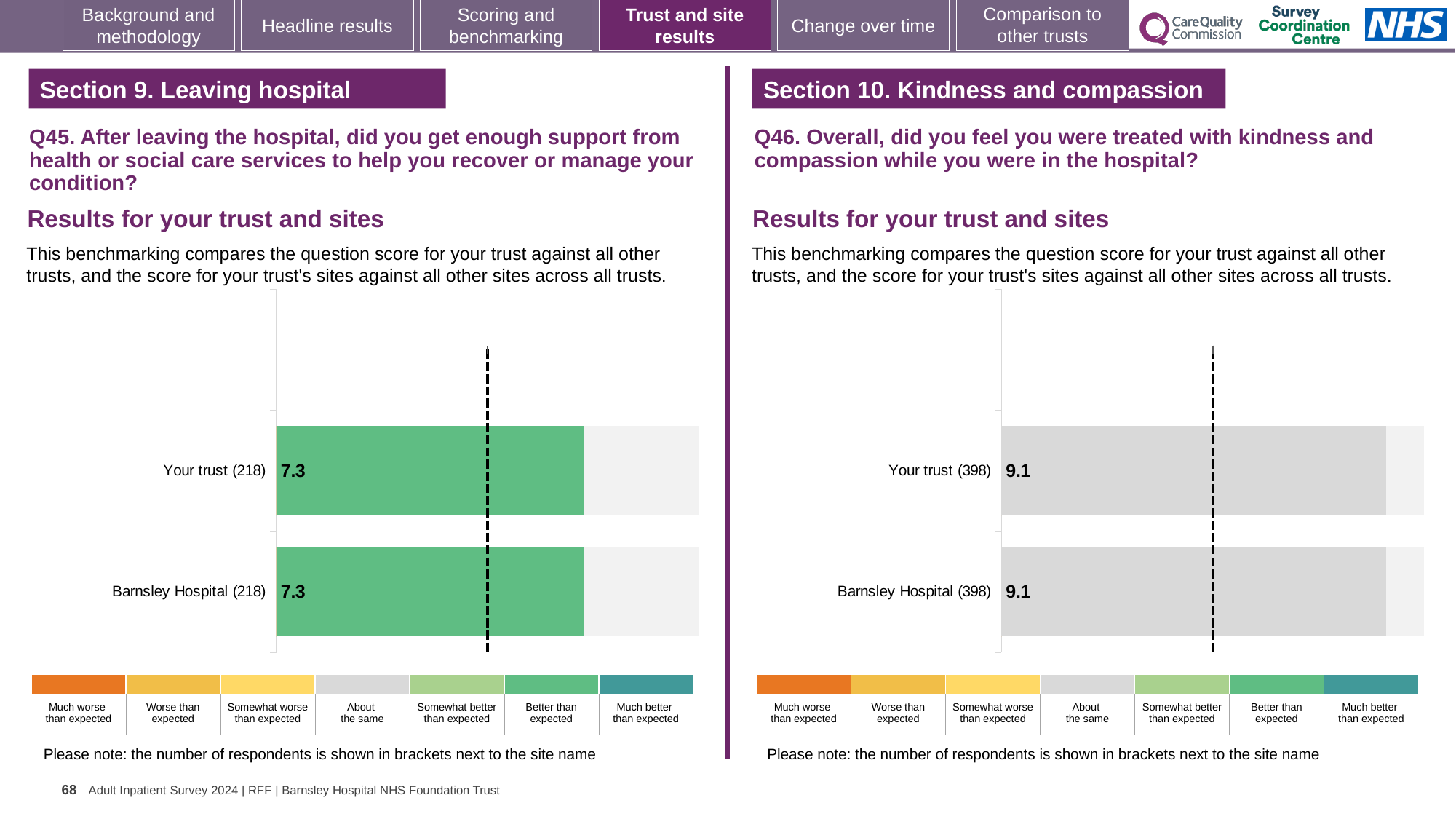
How many bars are plotted in the Q45 chart on the left? 2 In the Q45 chart on the left, what is the difference between the score for Your trust and the score for Barnsley Hospital? 0.0 In the Q46 chart on the right, how many respondents are shown in brackets for Barnsley Hospital? 398 In the Q45 chart on the left, what is the score for Barnsley Hospital? 7.3 What kind of chart is the Q45 chart on the left? Bar chart In the Q45 chart on the left, how many respondents are shown in brackets for Your trust? 218 In the Q46 chart on the right, which benchmark category does the grey colour of the bars correspond to in the key? About the same In the Q46 chart on the right, what is the score for Your trust? 9.1 In the Q46 chart on the right, what is the score for Barnsley Hospital? 9.1 How many bars are plotted in the Q46 chart on the right? 2 In the Q46 chart on the right, what is the difference between the score for Your trust and the score for Barnsley Hospital? 0.0 In the Q45 chart on the left, what is the score for Your trust? 7.3